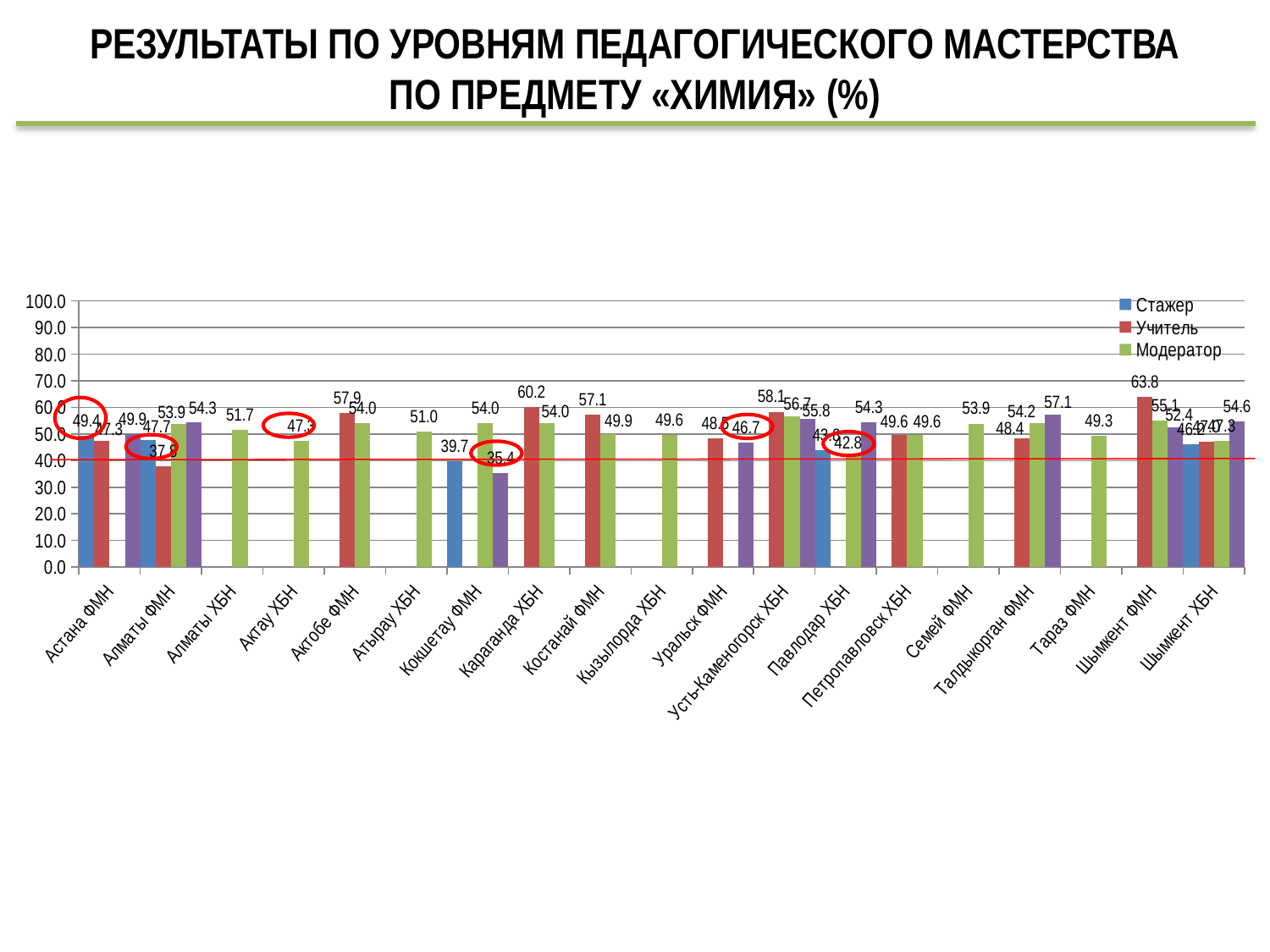
How many series does the legend list? 3 What is the value for Модератор in Семей ФМН? 53.9 At what value on the y axis is the red horizontal line drawn? 40.0 Is the value for Стажер in Павлодар ХБН greater or less than 40.0? greater In Караганда ХБН, which is larger: the Учитель value or the Модератор value? Учитель What is the value for Учитель in Караганда ХБН? 60.2 Which category has the highest Учитель value? Шымкент ФМН What is the value for Стажер in Кокшетау ФМН? 39.7 How many categories are shown on the x axis? 19 What is the difference between the Учитель and Модератор values for Актобе ФМН? 3.9 What is the value for Учитель in Шымкент ФМН? 63.8 What kind of chart is shown on the slide? Bar chart